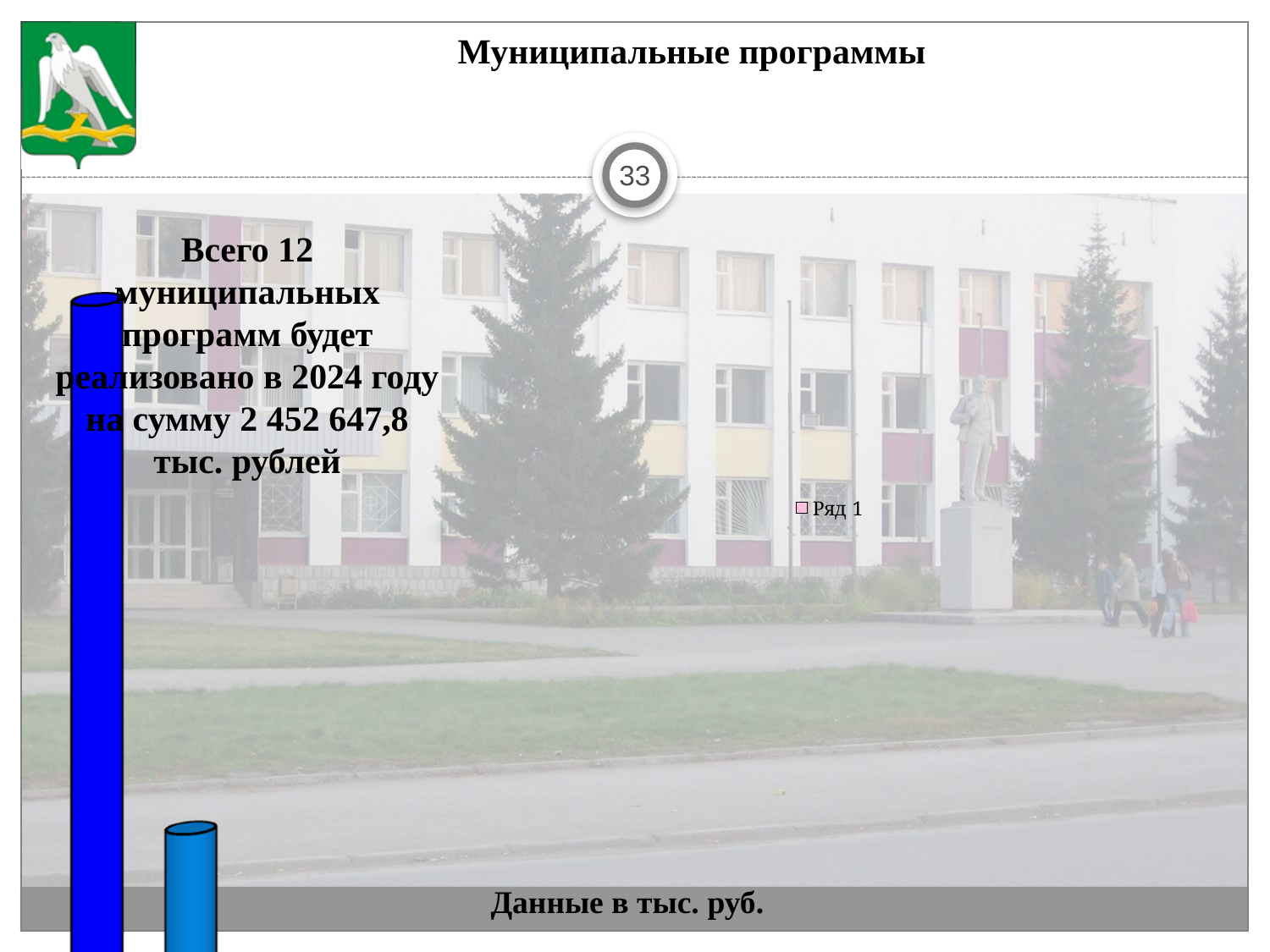
How many series does the chart legend list? 1 What colour are the bars in the chart? blue What kind of chart is shown on the slide? bar chart How many bars are visible in the chart on the slide? 2 What is the name of the series shown in the chart legend? Ряд 1 Which of the two visible bars is taller, the left one or the right one? the left one